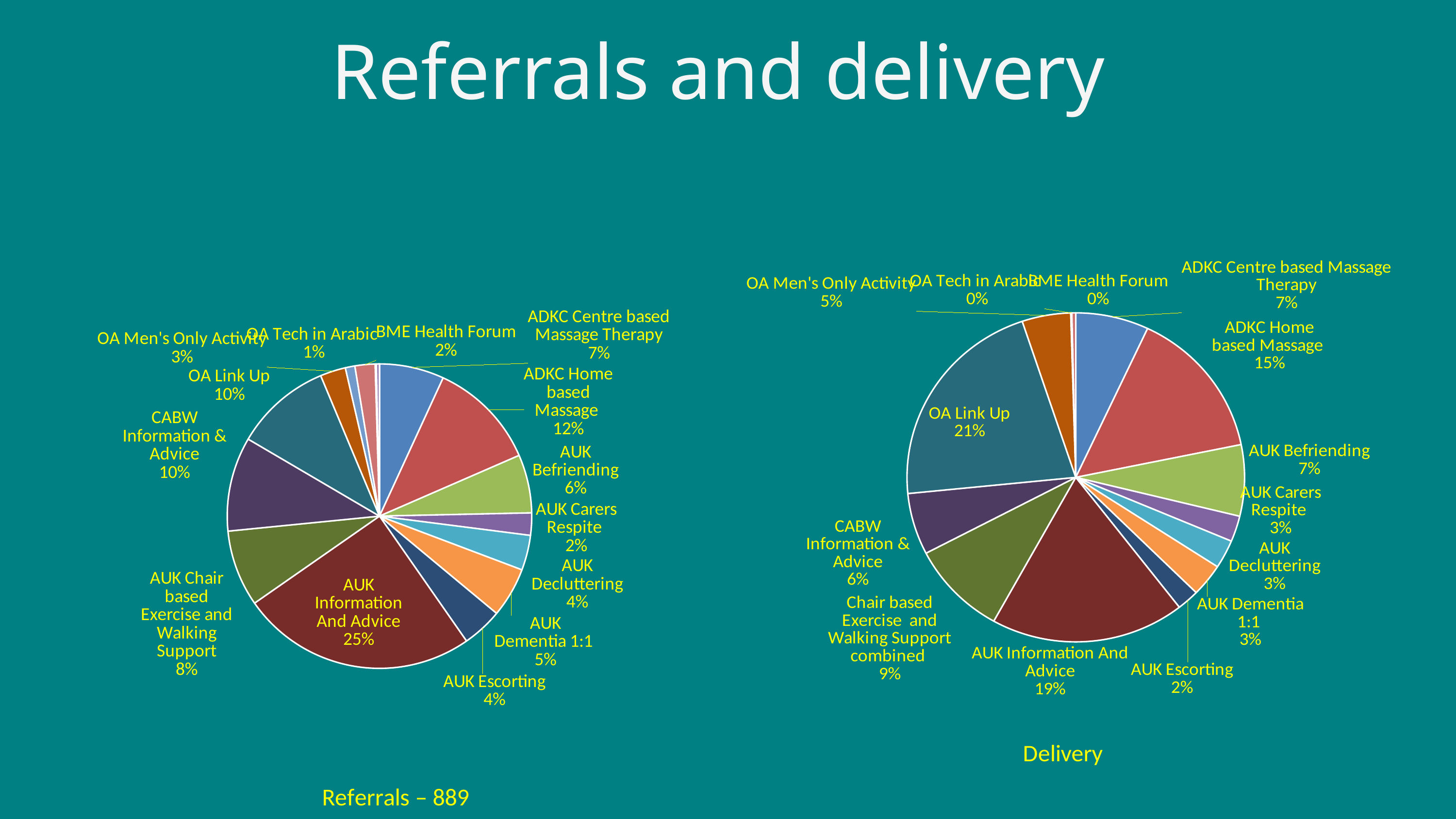
In the Referrals pie chart, what share does AUK Information And Advice have? 25% In the Delivery pie chart, what share does OA Link Up have? 21% In the Referrals pie chart, what is the share for ADKC Home based Massage? 12% How many categories are shown in the Delivery pie chart? 14 In the Delivery pie chart, what is the share for AUK Information And Advice? 19% What type of chart is used on the left side of the slide? Pie chart In the Referrals pie chart, which is larger: OA Link Up or AUK Befriending? OA Link Up In the Delivery pie chart, what is the difference in percentage points between OA Link Up and AUK Information And Advice? 2 What total number of referrals is stated below the left pie chart? 889 In the Referrals pie chart, which category has the largest slice? AUK Information And Advice In the Delivery pie chart, which category has the largest slice? OA Link Up